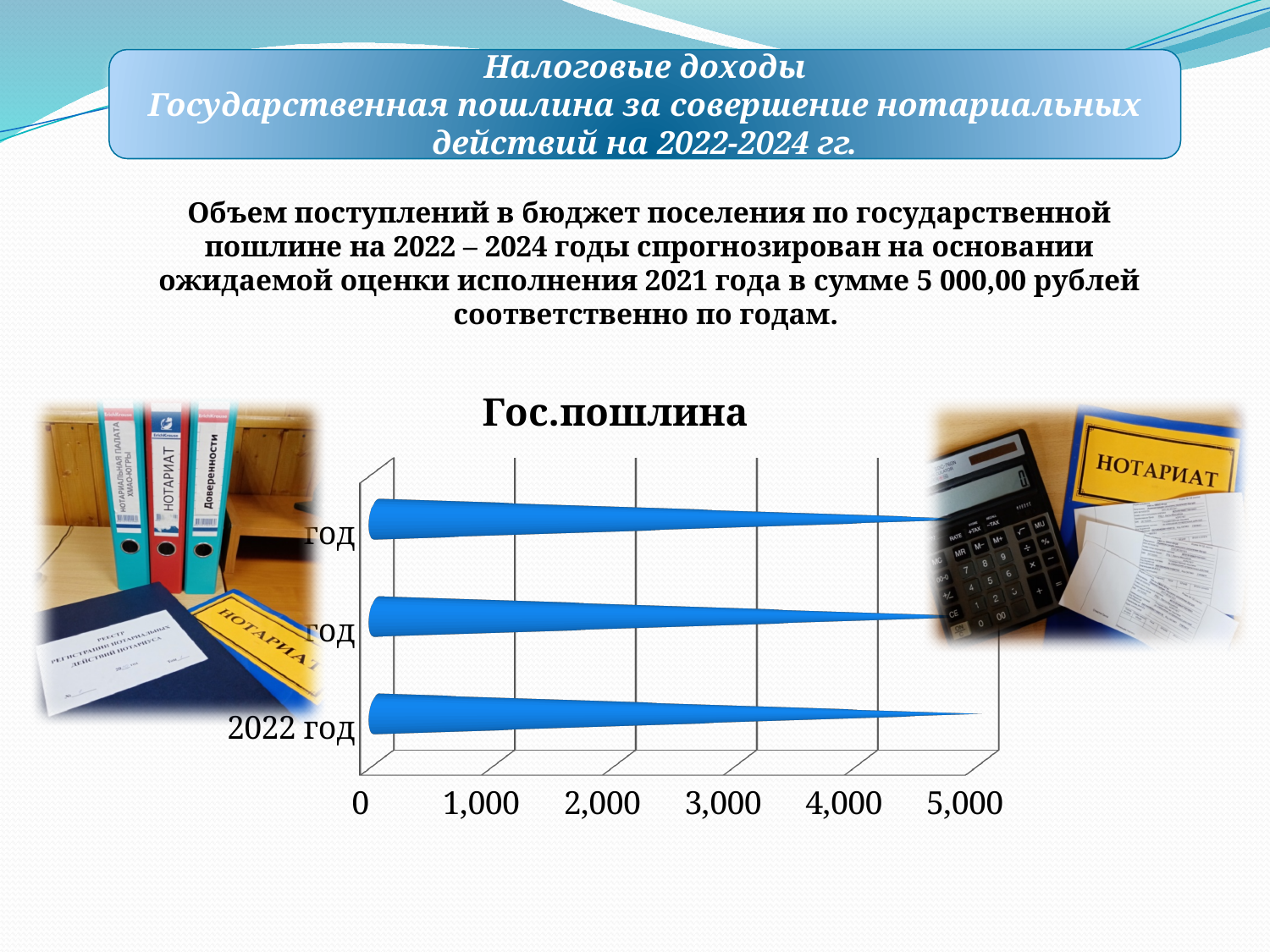
In the "Гос.пошлина" chart, is the value for 2022 год greater or less than 3,000? greater How many bars (categories) are plotted in the "Гос.пошлина" chart? 3 In the "Гос.пошлина" chart, is the value for 2022 год greater or less than 1,000? greater In the "Гос.пошлина" chart, is the value for 2022 год greater or less than 4,000? greater What is the highest tick value shown on the horizontal axis of the "Гос.пошлина" chart? 5,000 What is the title of the chart on the slide? Гос.пошлина What kind of chart is shown under the title "Гос.пошлина"? bar chart